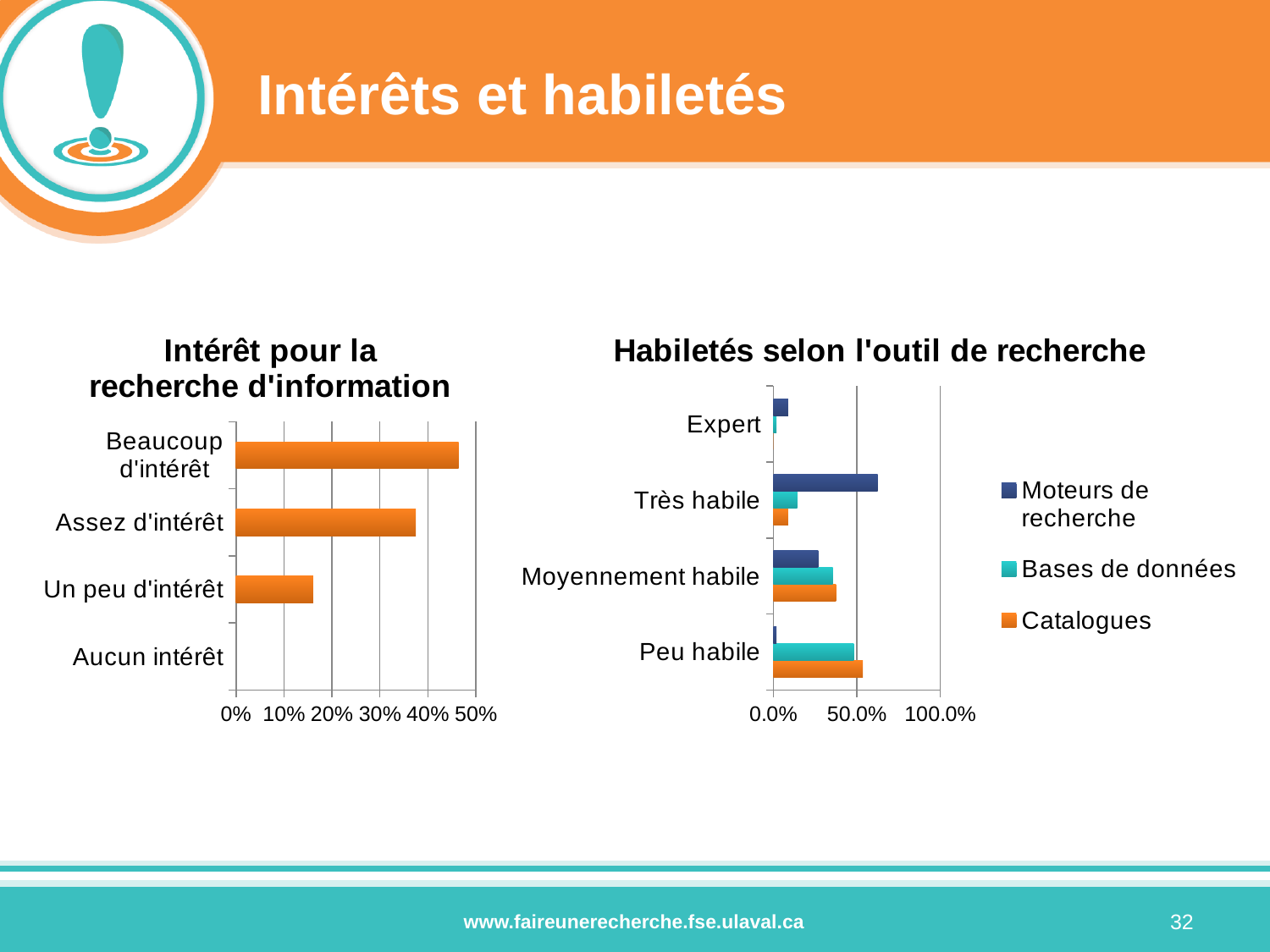
How many series does the legend of the "Habiletés selon l'outil de recherche" chart list? 3 In the "Intérêt pour la recherche d'information" chart, which category has the lowest value? Aucun intérêt In the "Intérêt pour la recherche d'information" chart, which category has the highest value? Beaucoup d'intérêt In the "Intérêt pour la recherche d'information" chart, is the value for "Un peu d'intérêt" greater or less than 20%? less How many categories does the "Intérêt pour la recherche d'information" chart show? 4 In the "Habiletés selon l'outil de recherche" chart, is the value of "Moteurs de recherche" for "Très habile" greater or less than 50.0%? greater What kind of chart is "Intérêt pour la recherche d'information"? bar chart In the "Intérêt pour la recherche d'information" chart, is the value for "Beaucoup d'intérêt" greater or less than 40%? greater In the "Habiletés selon l'outil de recherche" chart, which series has the larger value for "Peu habile": "Moteurs de recherche" or "Catalogues"? Catalogues In the "Habiletés selon l'outil de recherche" chart, which series is shown in orange? Catalogues In the "Habiletés selon l'outil de recherche" chart, which category has the highest value for "Moteurs de recherche"? Très habile In the "Intérêt pour la recherche d'information" chart, which is larger: "Assez d'intérêt" or "Un peu d'intérêt"? Assez d'intérêt